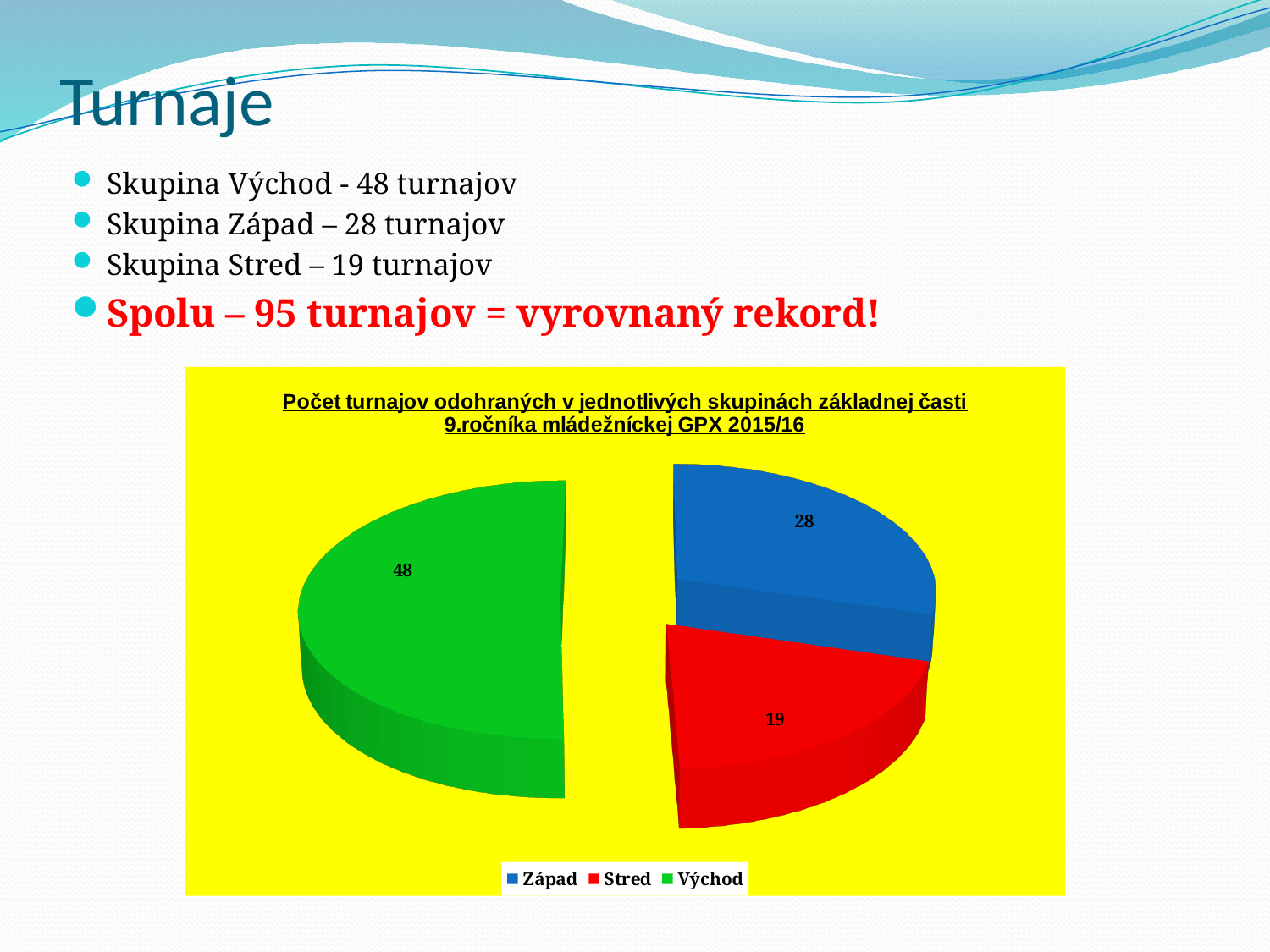
What type of chart is shown on the slide? pie chart What is the value for Stred in the pie chart? 19 Which group has the largest slice in the pie chart? Východ What is the value for Západ in the pie chart? 28 What is the value for Východ in the pie chart? 48 How many slices does the pie chart have? 3 What is the difference between the values for Východ and Západ? 20 What is the total of all slices in the pie chart? 95 What is the difference between the values for Západ and Stred? 9 Which group has the smallest slice in the pie chart? Stred Which is larger, the value for Západ or the value for Stred? Západ Which colour represents Stred in the pie chart? red